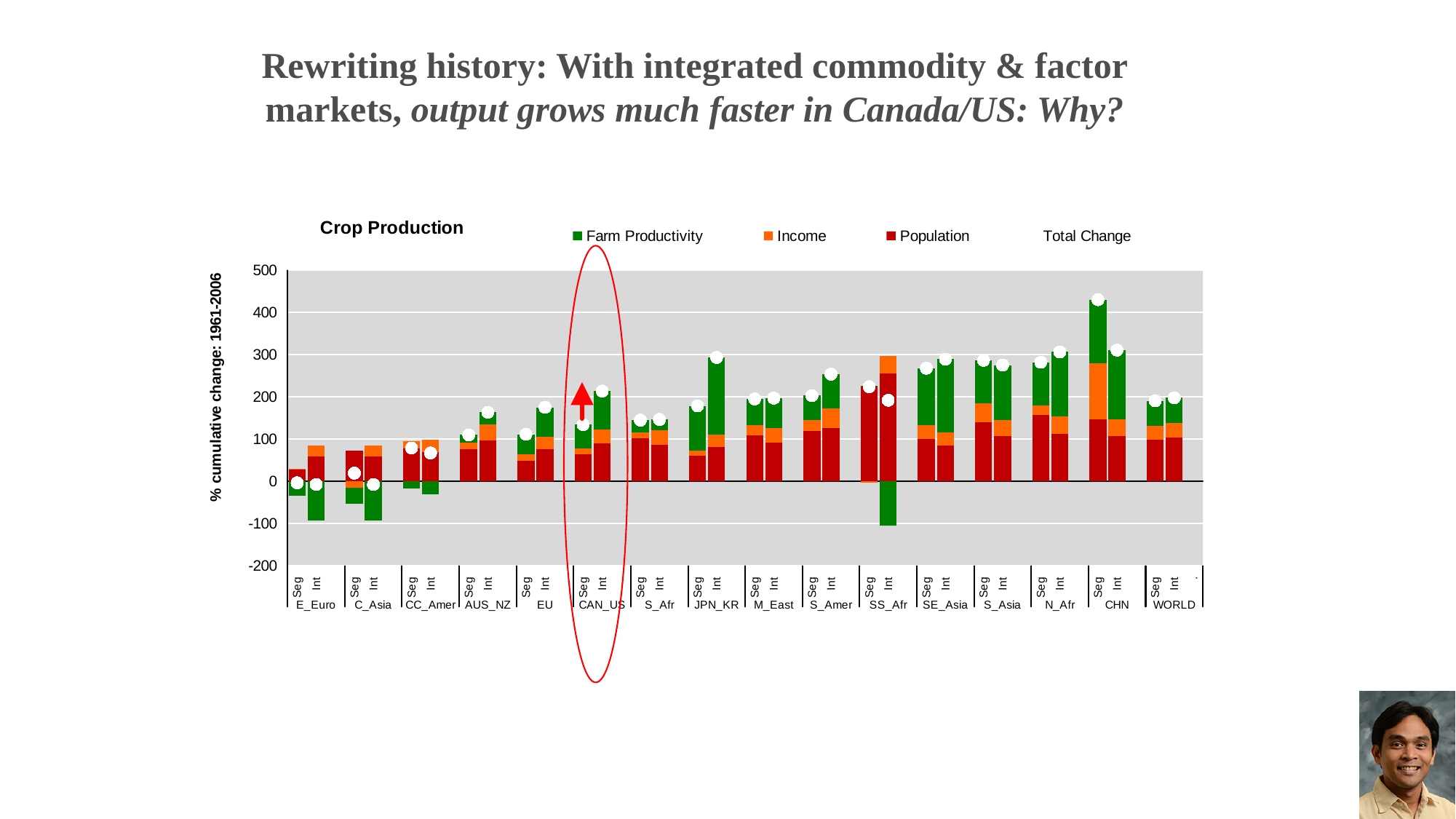
For CAN_US, which bar has the larger Total Change, Seg or Int? Int Which region's bars are circled in red on the chart? CAN_US How many entries does the chart legend list? 4 What type of chart is shown on the slide? Stacked bar chart What is the title of the chart? Crop Production Which region has the highest Total Change marker in the chart? CHN Is the Total Change for the JPN_KR Int bar greater or less than 200? greater Is the Total Change for the CAN_US Seg bar greater or less than 100? greater Is the Total Change for the E_Euro Int bar greater or less than 100? less For CHN, which bar has the larger Total Change, Seg or Int? Seg How many regions are shown along the x axis of the chart? 16